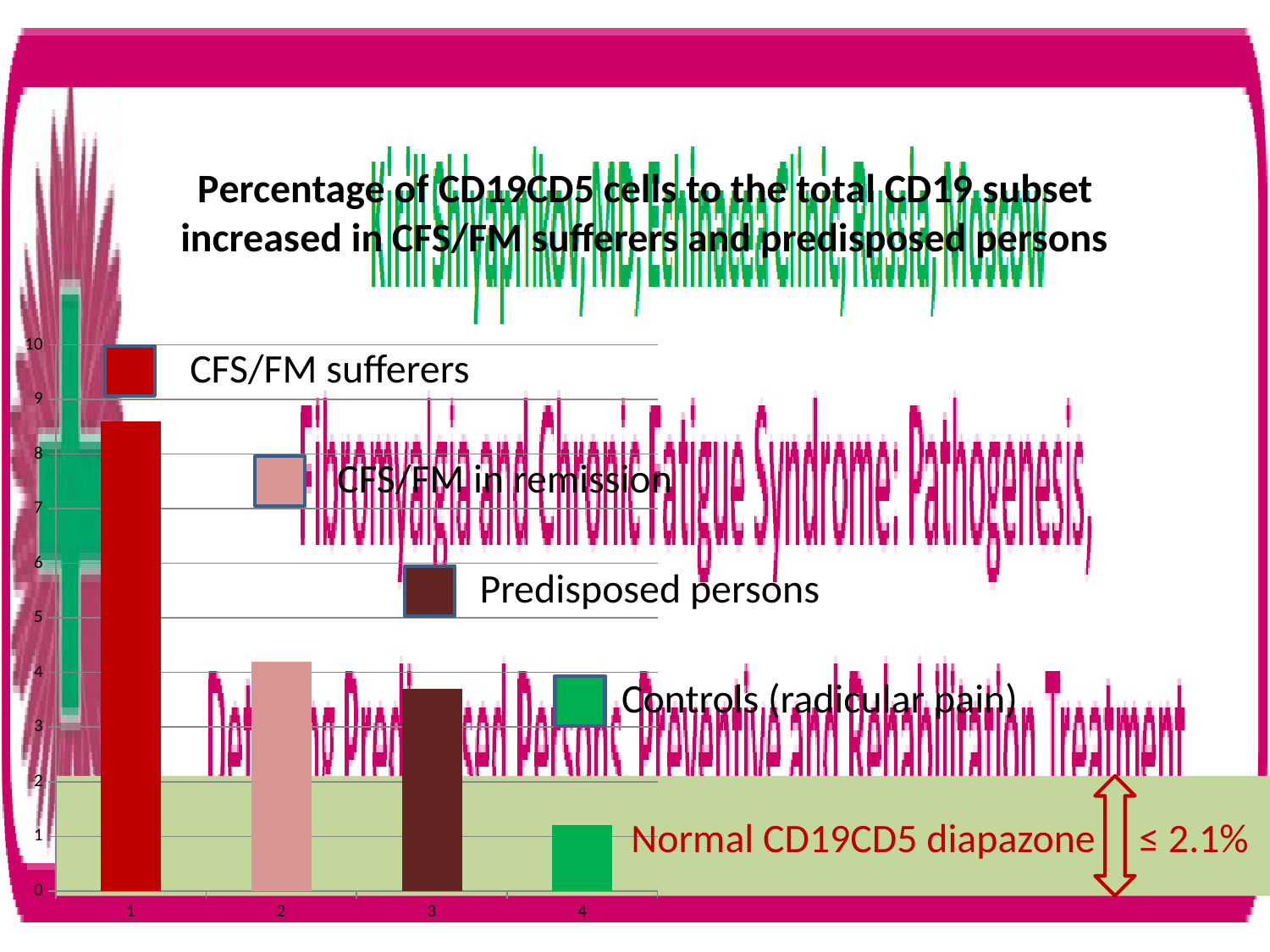
Which bar is the shortest in the chart? 4 (Controls (radicular pain)) Is the value for bar 1 (CFS/FM sufferers) greater or less than 8? greater Which group does the red bar represent according to the legend? CFS/FM sufferers Which bar is the tallest in the chart? 1 (CFS/FM sufferers) Is the value for bar 2 (CFS/FM in remission) greater or less than 5? less Which is larger, the value for bar 2 (CFS/FM in remission) or bar 3 (Predisposed persons)? bar 2 (CFS/FM in remission) Is the value for bar 3 (Predisposed persons) greater or less than 3? greater How many bars are plotted in the chart? 4 Do the bar values rise or fall from category 1 to category 4? fall What is the highest value shown on the vertical axis of the chart? 10 What kind of chart is shown on the slide? bar chart